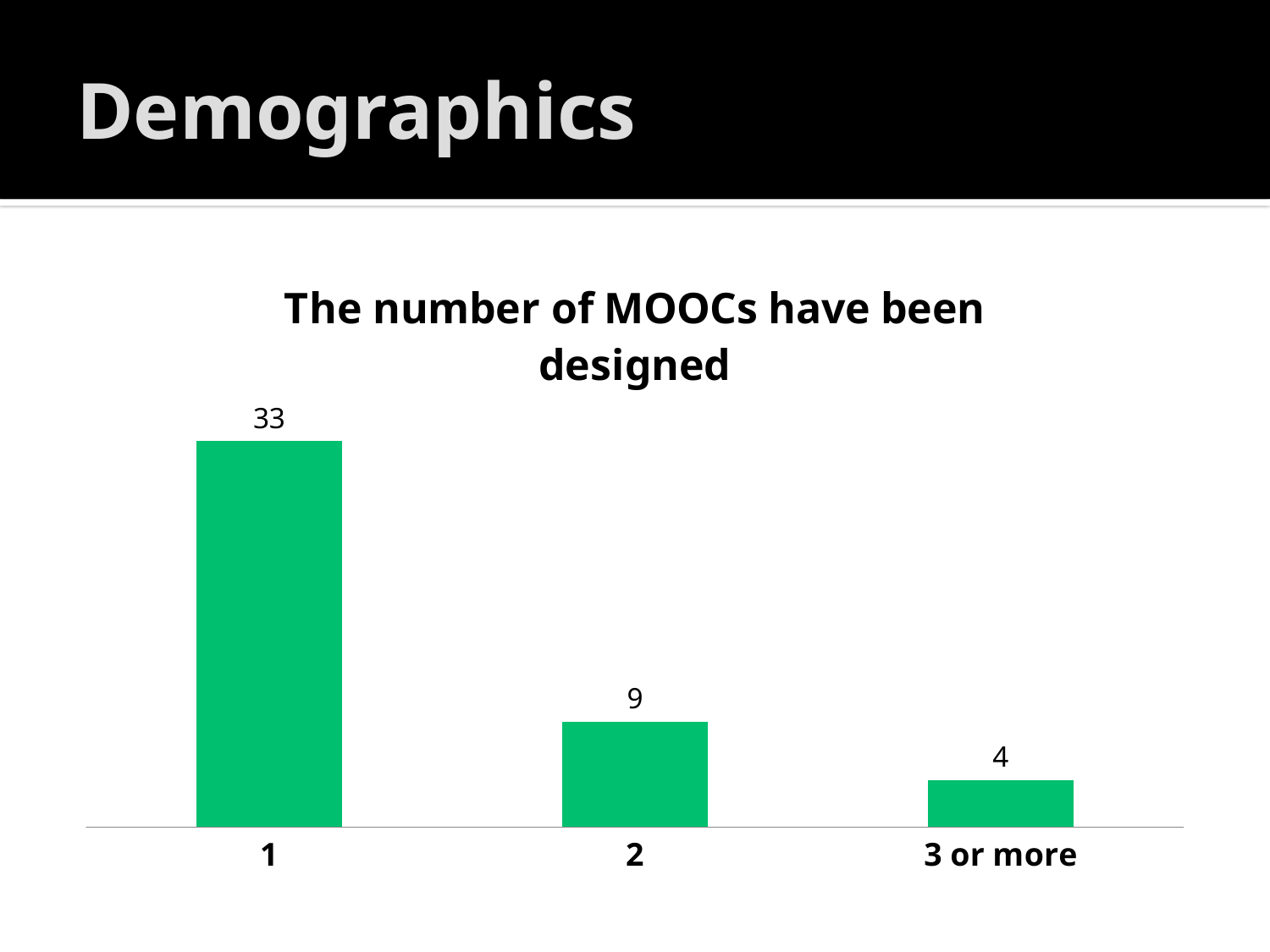
Do the values rise or fall from left to right along the x axis? fall What is the value for the category "3 or more"? 4 What is the title of the chart? The number of MOOCs have been designed Which is larger, the value for "2" or the value for "3 or more"? 2 Which category has the highest value? 1 What is the value for the category "2"? 9 How many categories are shown on the x axis? 3 What is the difference between the values for "1" and "2"? 24 What is the value for the category "1"? 33 What is the difference between the values for "2" and "3 or more"? 5 Which category has the lowest value? 3 or more What kind of chart is shown on the slide? bar chart